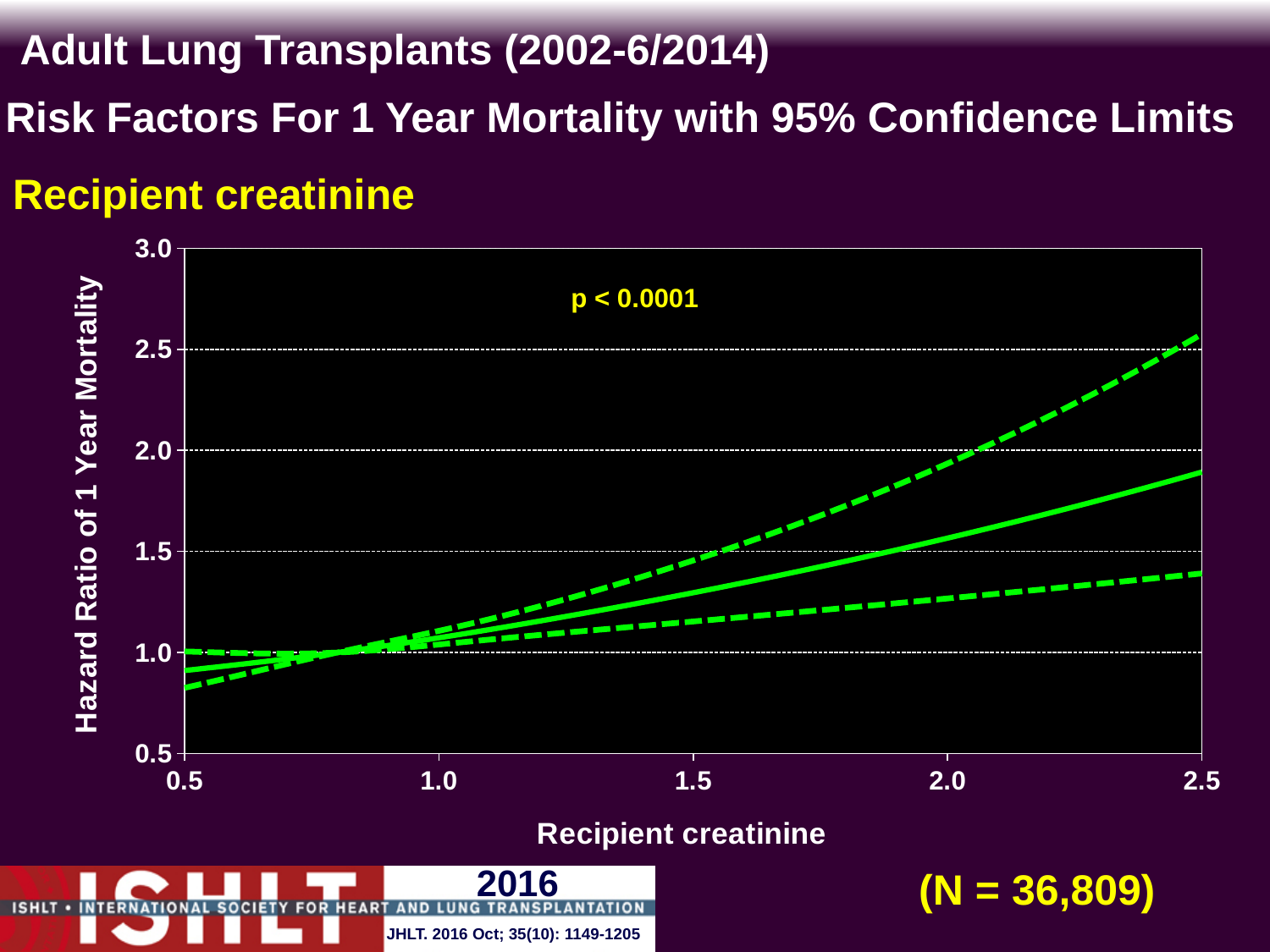
Is the hazard ratio (solid line) at a recipient creatinine of 1.5 greater or less than 1.5? less Is the lower confidence limit (lower dashed line) at a recipient creatinine of 2.5 greater or less than 1.5? less How many lines are plotted on the chart? 3 Is the hazard ratio (solid line) at a recipient creatinine of 1.5 greater or less than 1.0? greater What is the label of the y axis? Hazard Ratio of 1 Year Mortality Does the hazard ratio (solid line) rise or fall as recipient creatinine increases along the x axis? rise At a recipient creatinine of 2.5, which is larger: the upper confidence limit (upper dashed line) or the hazard ratio (solid line)? upper confidence limit What kind of chart is shown on the slide? line chart What p-value is printed on the chart? p < 0.0001